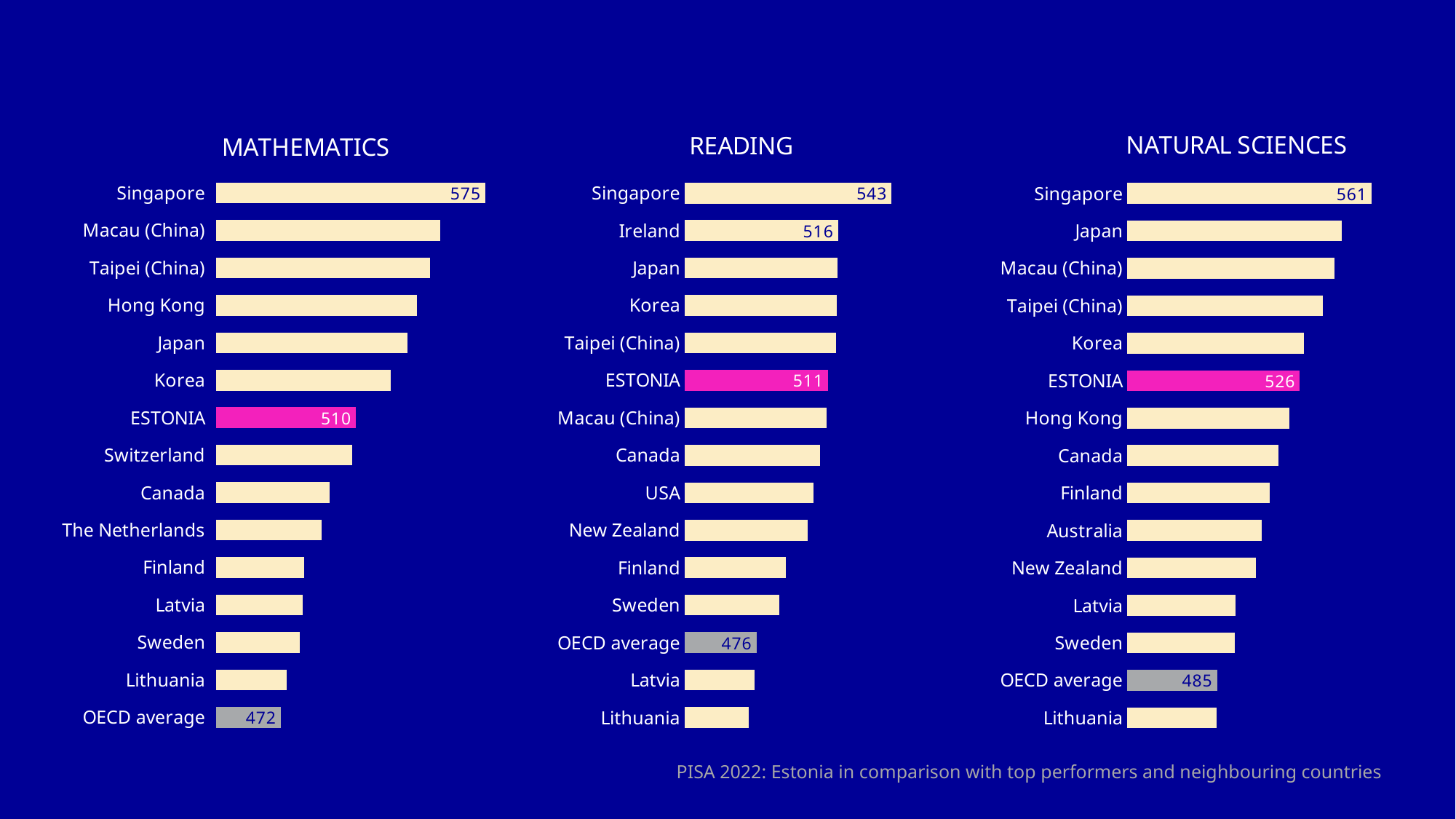
How many categories are shown in the READING chart? 15 In the MATHEMATICS chart, which category has the lowest value? OECD average In the MATHEMATICS chart, what is the value for Singapore? 575 In the READING chart, which category has the highest value? Singapore In the READING chart, what is the value for Ireland? 516 In the NATURAL SCIENCES chart, which category has the lowest value? Lithuania In the READING chart, what is the difference between ESTONIA's value and the OECD average? 35 What kind of chart is the NATURAL SCIENCES chart? Bar chart In the NATURAL SCIENCES chart, what is the value for the OECD average? 485 In the MATHEMATICS chart, what is the difference between Singapore's value and ESTONIA's value? 65 In the NATURAL SCIENCES chart, which is larger, the value for Korea or the value for Canada? Korea In the MATHEMATICS chart, what is the value for ESTONIA? 510